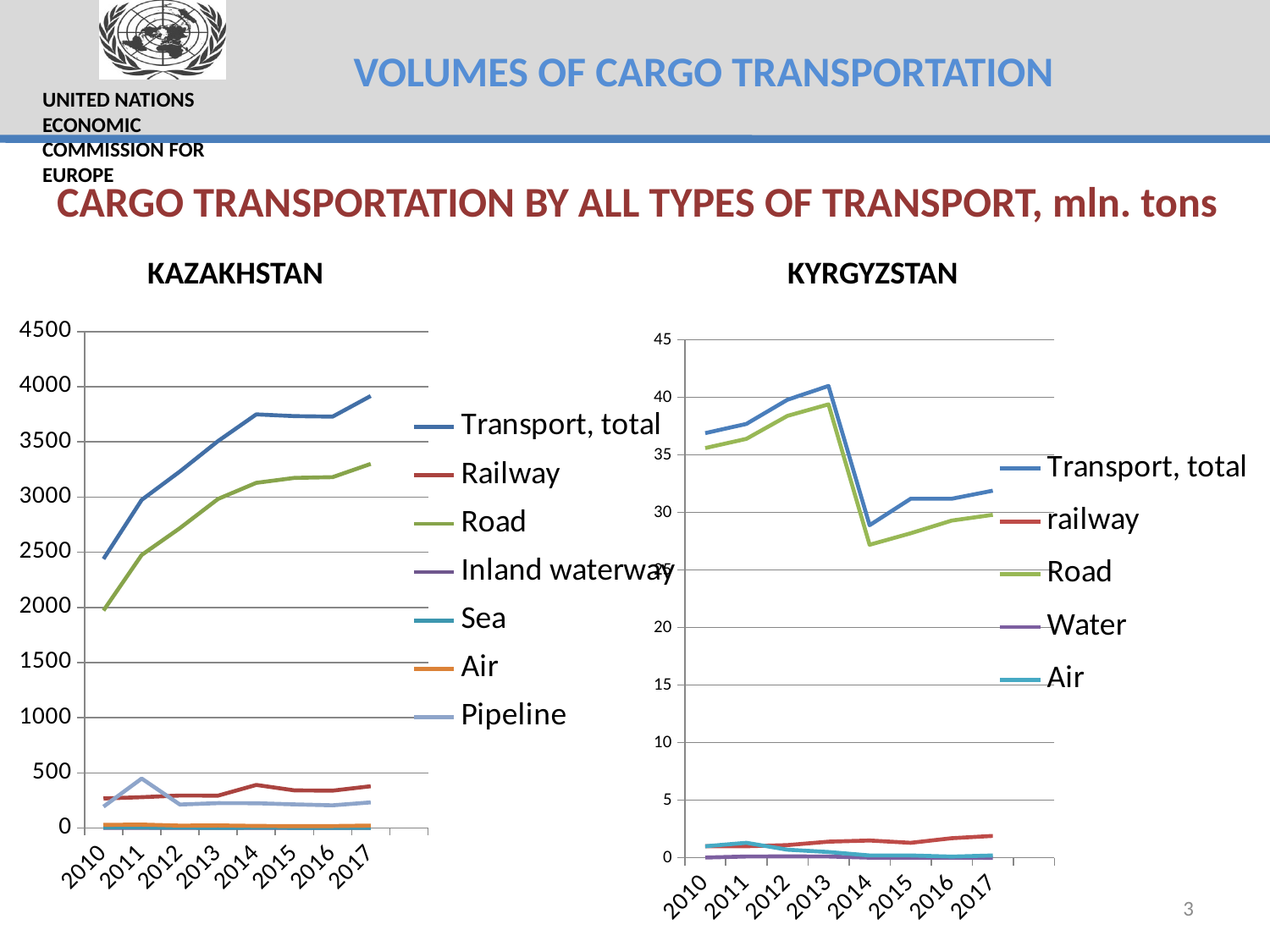
In the KYRGYZSTAN chart, is the value for Road in 2014 greater or less than 30? less How many series does the legend of the KAZAKHSTAN chart list? 7 In the KAZAKHSTAN chart, which series has the highest values across all years? Transport, total How many years are shown on the x axis of the KYRGYZSTAN chart? 8 In the KYRGYZSTAN chart, in which year does Transport, total reach its highest value? 2013 What type of chart is the KAZAKHSTAN chart? line chart In the KAZAKHSTAN chart, is the value for Transport, total in 2017 greater or less than 3500? greater In the KAZAKHSTAN chart, is the value for Road in 2010 greater or less than 2500? less How many series does the legend of the KYRGYZSTAN chart list? 5 In the KYRGYZSTAN chart, in which year does Transport, total reach its lowest value? 2014 In the KAZAKHSTAN chart, does the Transport, total line rise or fall from 2010 to 2017? rises In the KAZAKHSTAN chart, which is larger in 2017, Railway or Pipeline? Railway